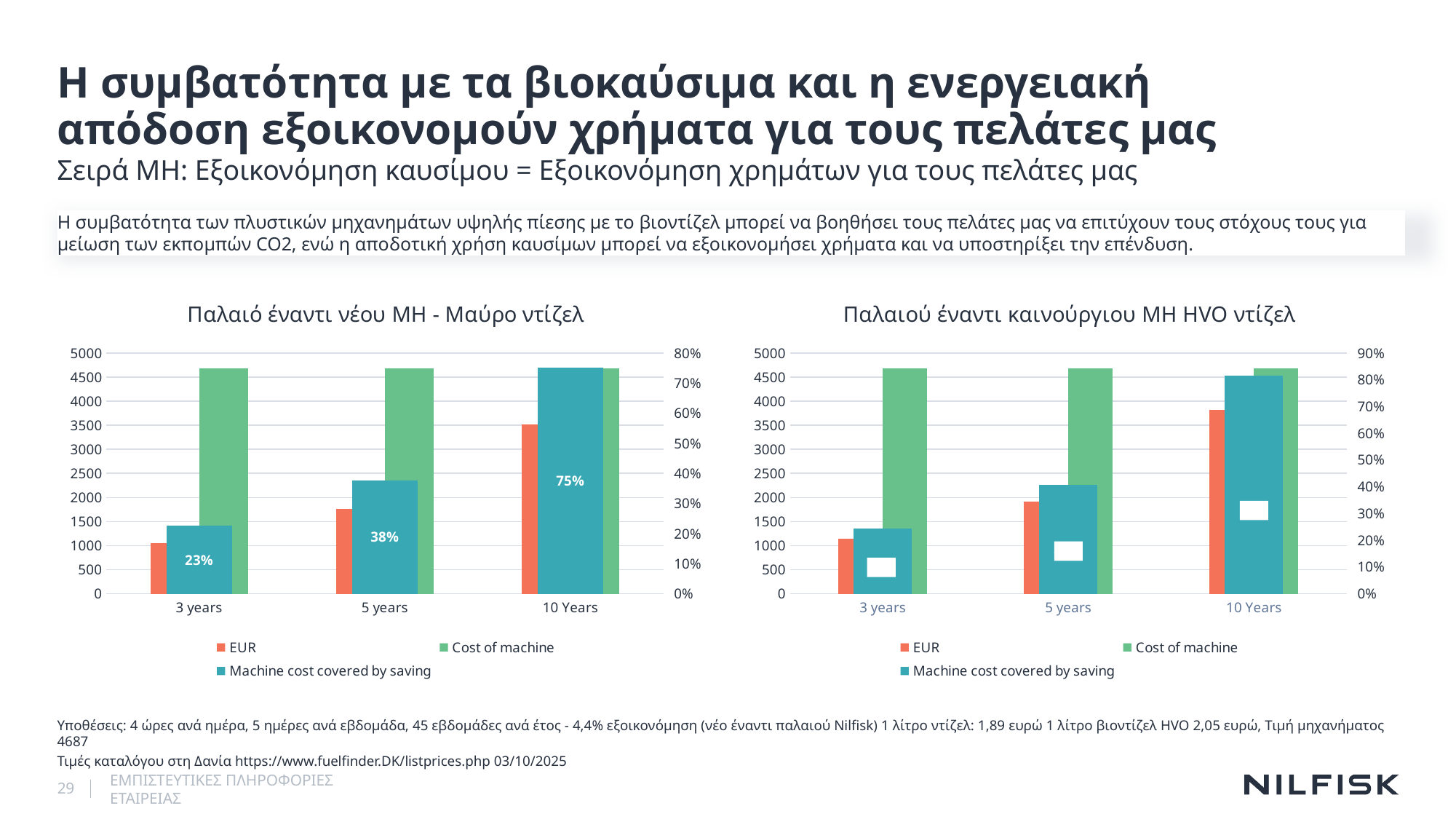
In the left chart (Παλαιό έναντι νέου MH - Μαύρο ντίζελ), what is the value of Machine cost covered by saving at 10 Years? 75% In the right chart (Παλαιού έναντι καινούργιου MH HVO ντίζελ), how many series does the legend list? 3 In the left chart (Παλαιό έναντι νέου MH - Μαύρο ντίζελ), what is the value of Machine cost covered by saving at 3 years? 23% In the right chart (Παλαιού έναντι καινούργιου MH HVO ντίζελ), how many categories are shown on the x axis? 3 In the right chart (Παλαιού έναντι καινούργιου MH HVO ντίζελ), is the EUR value for 10 Years greater or less than 3500? greater In the left chart (Παλαιό έναντι νέου MH - Μαύρο ντίζελ), which category has the lowest Machine cost covered by saving? 3 years In the left chart (Παλαιό έναντι νέου MH - Μαύρο ντίζελ), what is the difference between the Machine cost covered by saving at 10 Years and at 3 years? 52% In the left chart (Παλαιό έναντι νέου MH - Μαύρο ντίζελ), which category has the highest Machine cost covered by saving? 10 Years What kind of chart is the left chart (Παλαιό έναντι νέου MH - Μαύρο ντίζελ)? bar chart In the right chart (Παλαιού έναντι καινούργιου MH HVO ντίζελ), does the EUR value rise or fall from 3 years to 10 Years? rise In the left chart (Παλαιό έναντι νέου MH - Μαύρο ντίζελ), what is the value of Machine cost covered by saving at 5 years? 38% In the right chart (Παλαιού έναντι καινούργιου MH HVO ντίζελ), which is larger, the EUR value at 10 Years or at 3 years? 10 Years